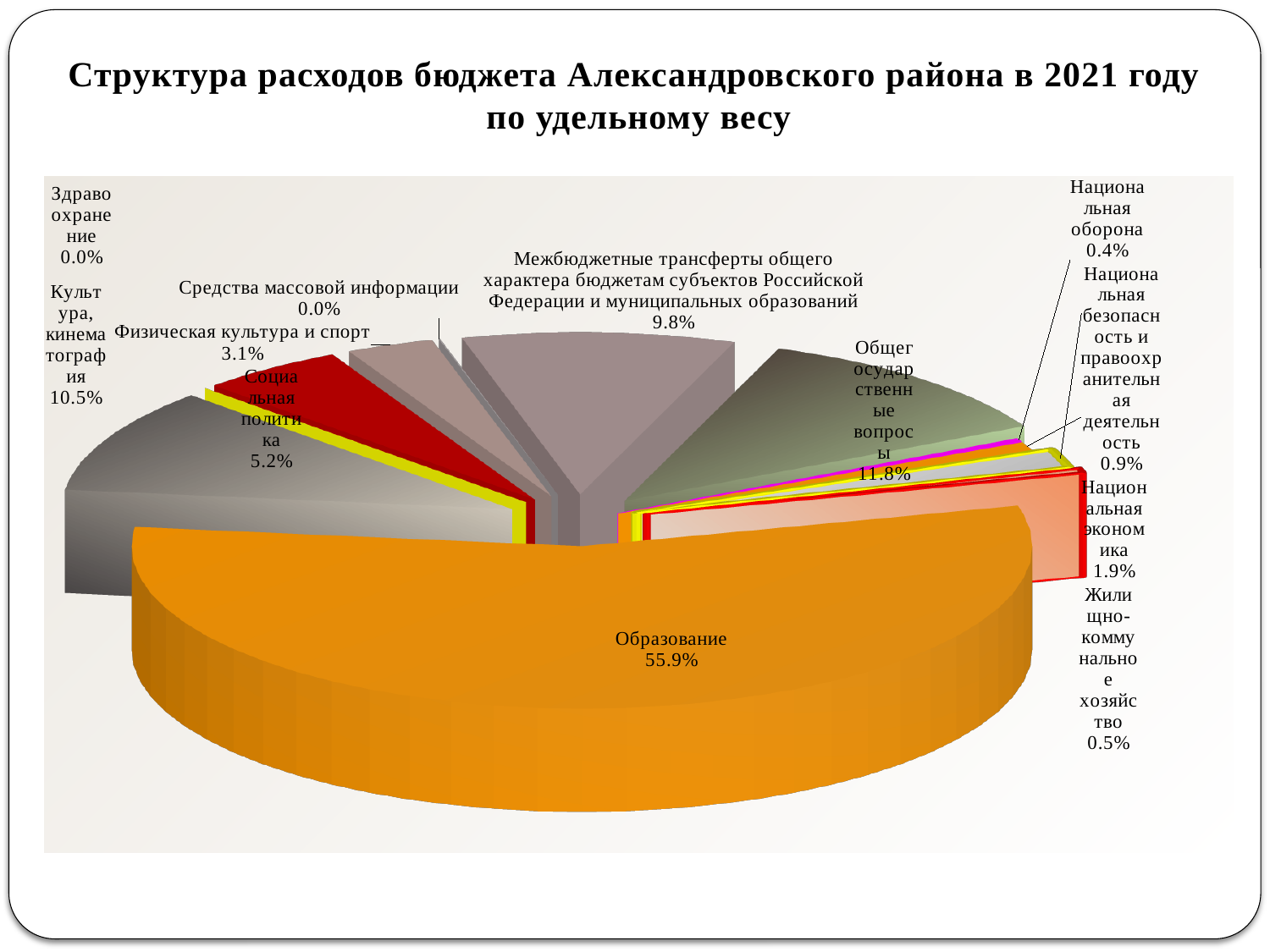
Which two categories are shown with a share of 0.0%? Здравоохранение and Средства массовой информации What kind of chart is shown on the slide? Pie chart What is the value for Межбюджетные трансферты общего характера бюджетам субъектов Российской Федерации и муниципальных образований? 9.8% What is the title of the slide? Структура расходов бюджета Александровского района в 2021 году по удельному весу What is the value shown for Общегосударственные вопросы? 11.8% Which category has the largest share of the pie? Образование What is the difference between the shares of Общегосударственные вопросы and Культура, кинематография? 1.3% Which is larger: the share for Социальная политика or for Физическая культура и спорт? Социальная политика What share is shown for Национальная оборона? 0.4% How many categories are labelled on the pie chart? 12 What share of the budget expenditure goes to Образование? 55.9% What percentage is shown for Культура, кинематография? 10.5%